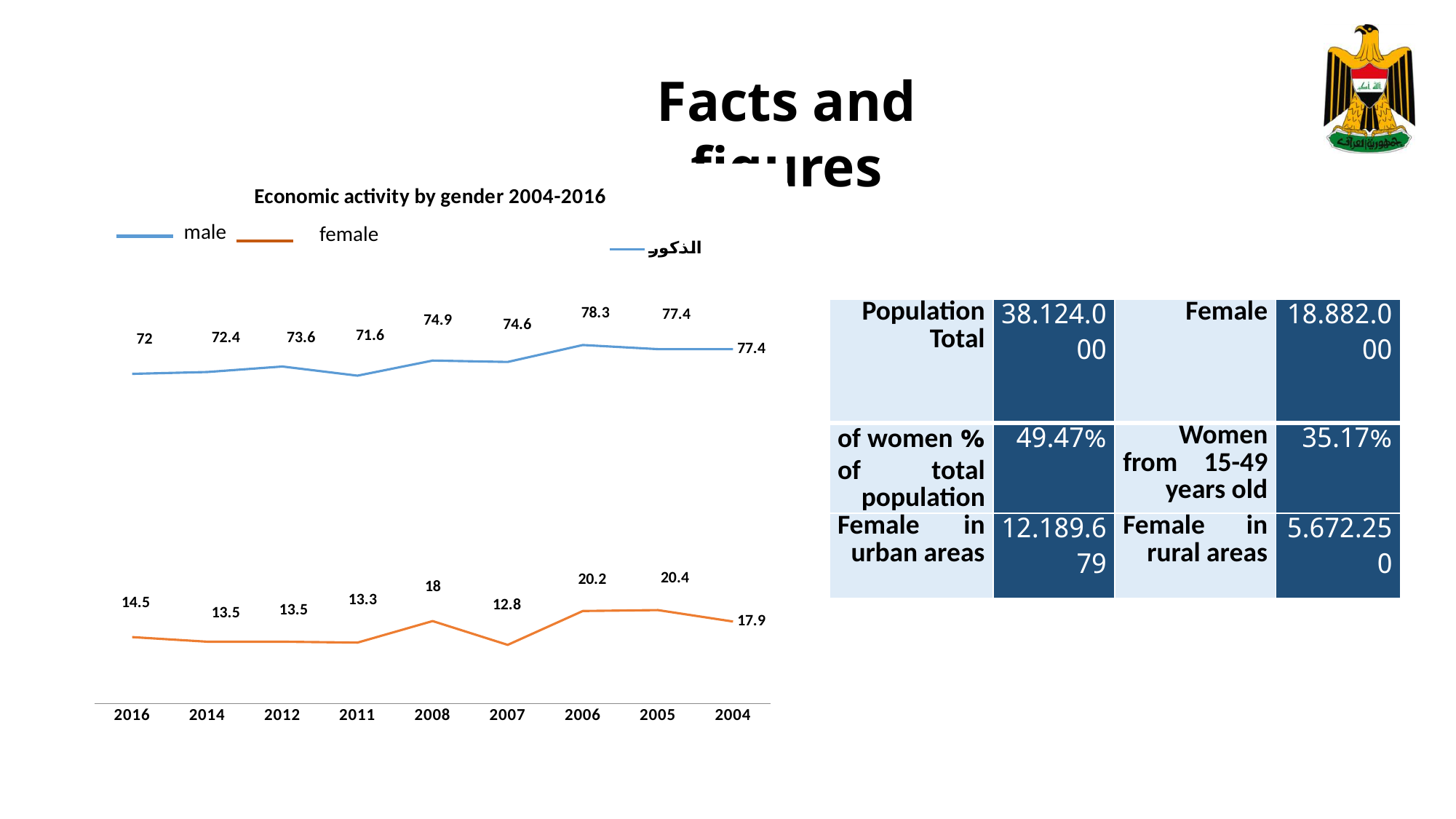
What is the title of the line chart on the slide? Economic activity by gender 2004-2016 In which year does the female series have its lowest value in the 'Economic activity by gender 2004-2016' chart? 2007 What is the female value for 2004 in the 'Economic activity by gender 2004-2016' chart? 17.9 Which is larger in the 'Economic activity by gender 2004-2016' chart: the male value for 2006 or the male value for 2011? 2006 What is the difference between the female values for 2005 and 2004 in the 'Economic activity by gender 2004-2016' chart? 2.5 In which year does the male series reach its highest value in the 'Economic activity by gender 2004-2016' chart? 2006 What is the female value for 2008 in the 'Economic activity by gender 2004-2016' chart? 18 In which year does the female series reach its highest value in the 'Economic activity by gender 2004-2016' chart? 2005 What is the difference between the male and female values for 2016 in the 'Economic activity by gender 2004-2016' chart? 57.5 How many years are shown on the x axis of the 'Economic activity by gender 2004-2016' chart? 9 What is the male value for 2016 in the 'Economic activity by gender 2004-2016' chart? 72 What kind of chart is 'Economic activity by gender 2004-2016'? line chart